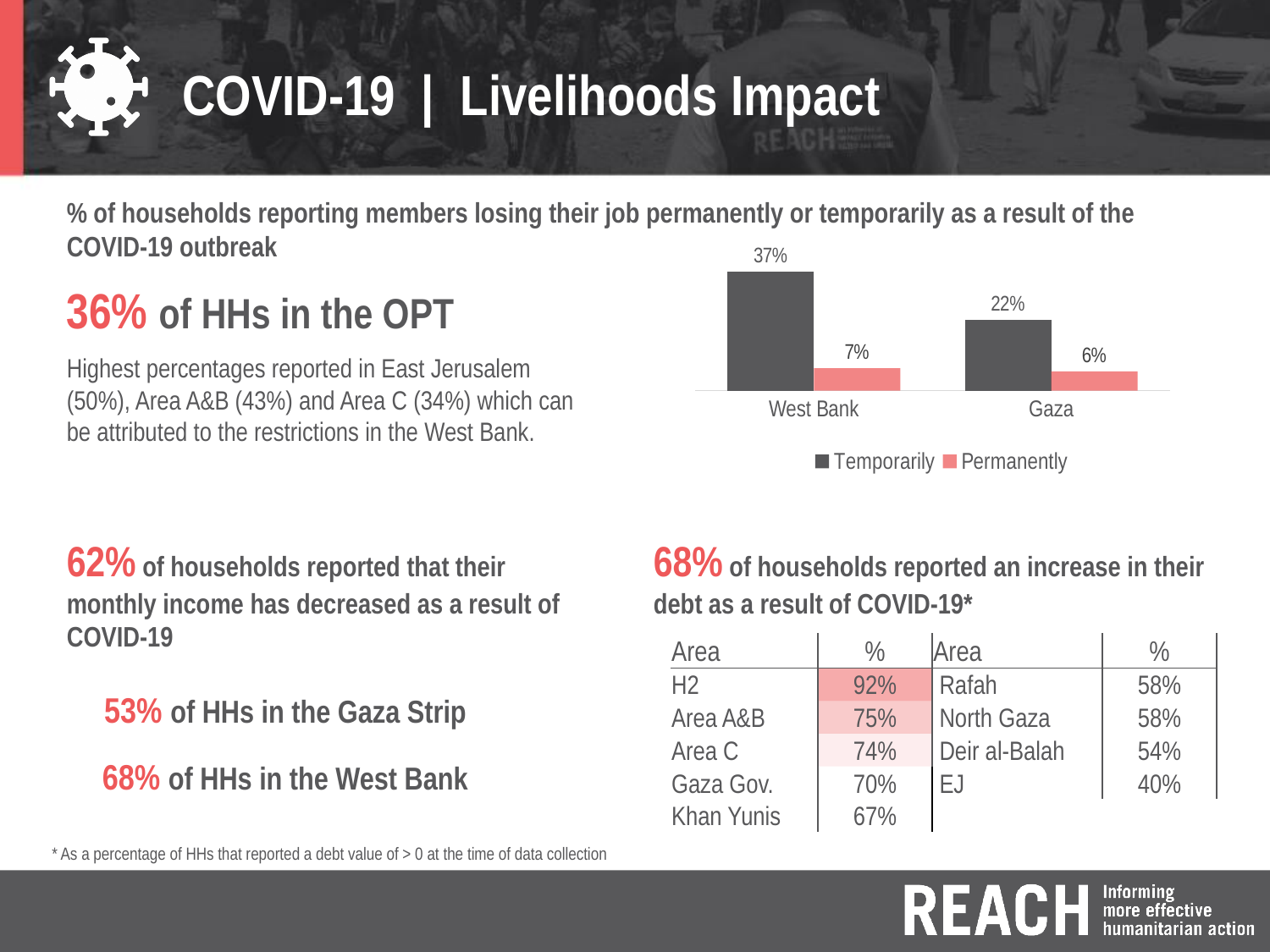
How many regions are shown on the x axis of the chart? 2 What is the value of the Permanently bar for the West Bank? 7% What type of chart is used to show job loss by region? Bar chart How many series does the chart's legend list? 2 What is the difference between the Temporarily values for the West Bank and Gaza? 15% What percentage of households in the West Bank reported members losing their job temporarily? 37% What percentage of households in Gaza reported members losing their job permanently? 6% Which bar in the chart has the lowest value? Gaza, Permanently What is the difference between the Temporarily and Permanently values for the West Bank? 30% What is the value of the Temporarily bar for Gaza? 22% Which region has the higher value for Temporarily job loss? West Bank Which bar in the chart has the highest value? West Bank, Temporarily